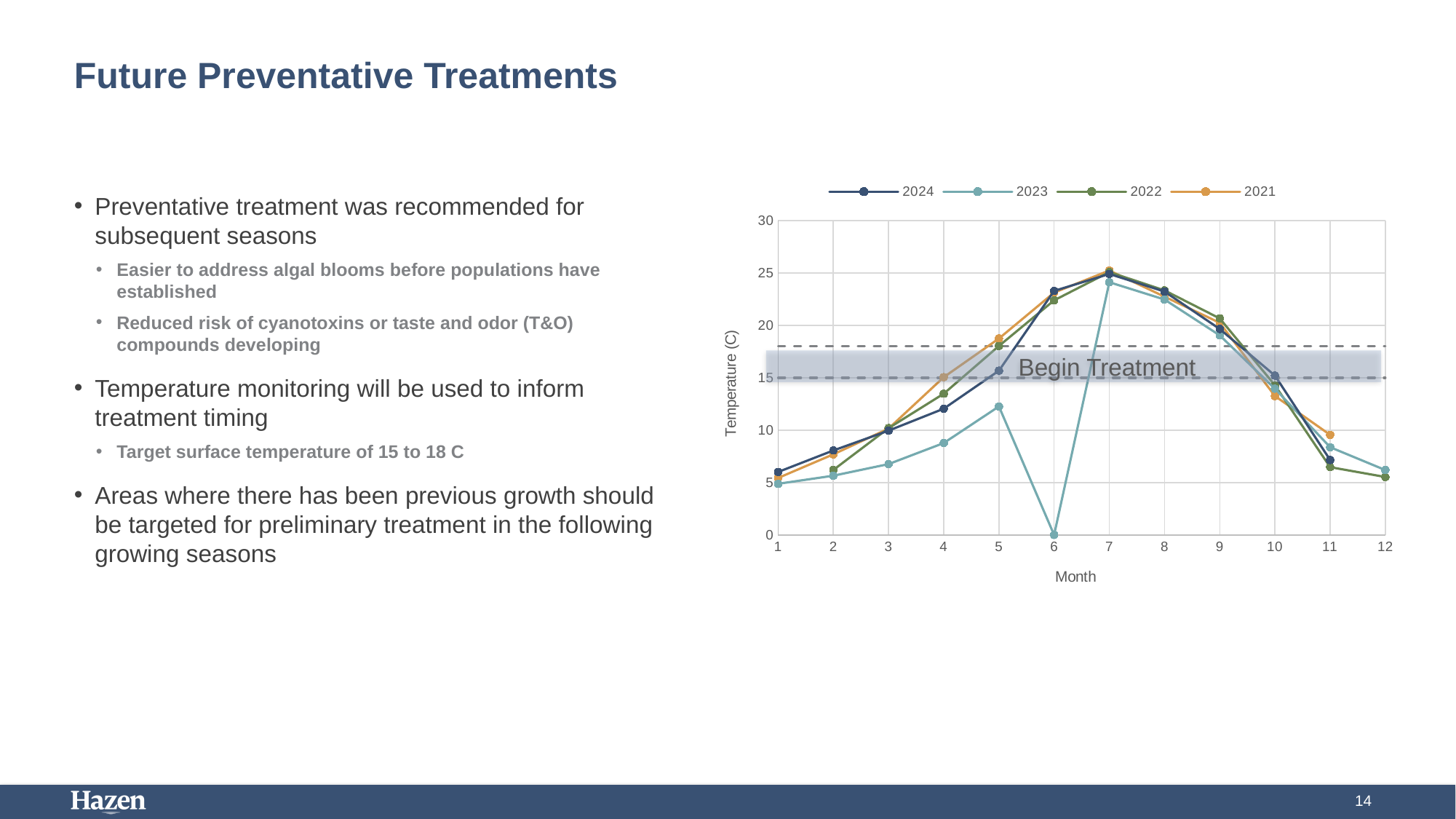
How many months are plotted along the x axis of the chart? 12 How many series does the chart legend list? 4 Is the 2023 value for month 5 greater or less than 15? less Is the 2022 value for month 12 greater or less than 10? less In which month does the 2023 series reach its lowest temperature? 6 What is the label on the y axis of the chart? Temperature (C) Do the temperatures rise or fall from month 7 to month 12 for the 2022 series? fall At month 4, which series has the higher temperature, 2024 or 2023? 2024 In which month does the 2024 series reach its highest temperature? 7 What kind of chart is shown on the slide? line chart Is the 2024 value for month 7 greater or less than 20? greater